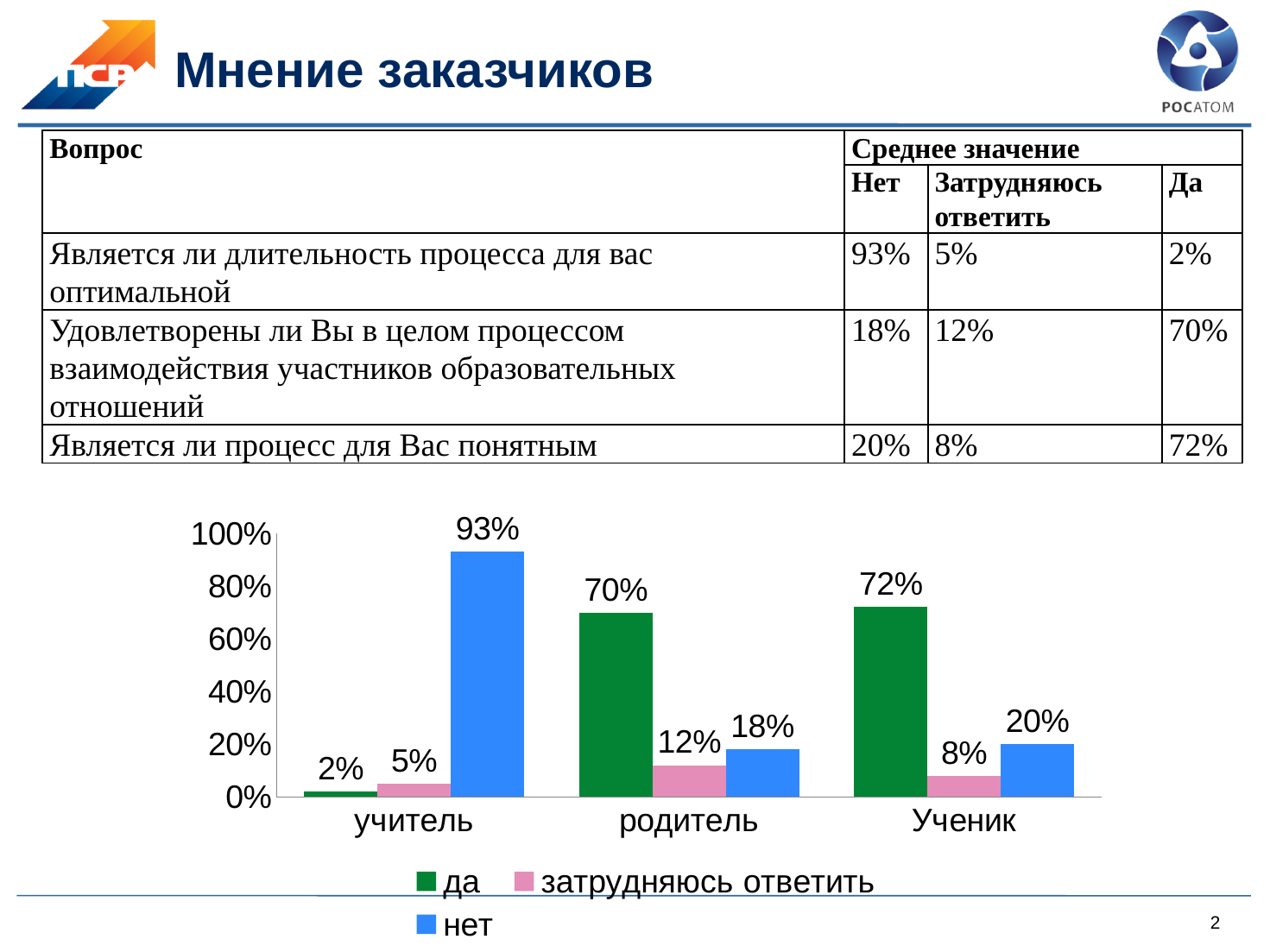
What is the difference between the 'нет' value for 'Ученик' and the 'нет' value for 'родитель'? 2% Which is larger: the 'затрудняюсь ответить' value for 'родитель' or for 'учитель'? родитель What type of chart is shown on the slide? bar chart How many series does the chart legend list? 3 Which category has the lowest value for the 'нет' series? родитель Is the 'да' value for 'учитель' greater or less than 20%? less Which series in the legend is shown in blue? нет What is the value of the 'да' series for 'родитель'? 70% What is the value of the 'затрудняюсь ответить' series for 'Ученик'? 8% Which category has the highest value for the 'да' series? Ученик What is the value of the 'нет' series for 'учитель'? 93% How many categories are shown on the x axis of the chart? 3